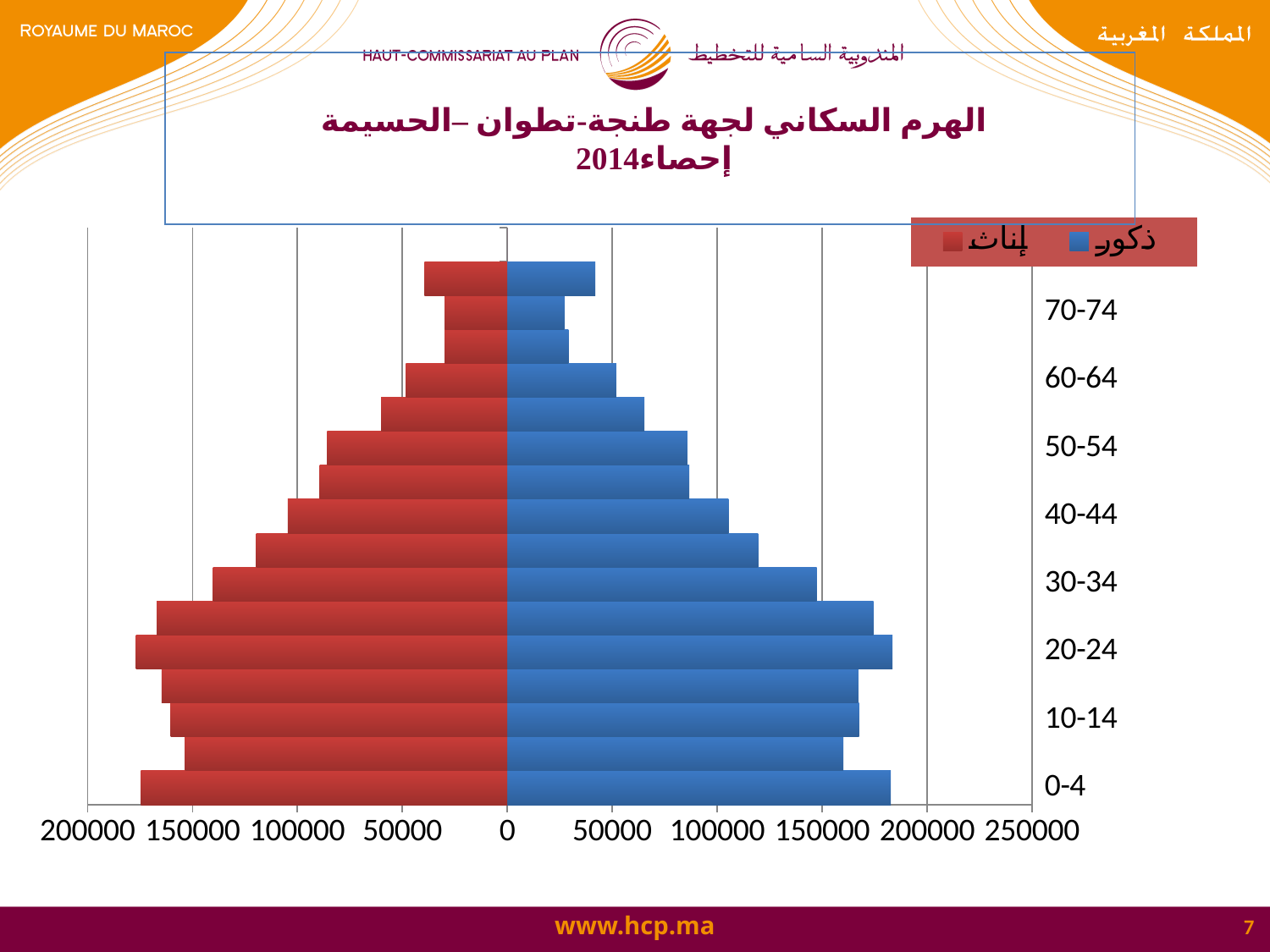
Is the value for males (ذكور) in the 50-54 age group greater or less than 100000? less Is the value for females (إناث) in the 0-4 age group greater or less than 150000? greater Is the value for males (ذكور) in the 0-4 age group greater or less than 150000? greater What kind of chart is shown on the slide? bar chart Which colour represents the ذكور (males) series? blue As the age groups increase from 0-4 to 70-74, do the bars generally get longer or shorter? shorter Which is larger: the male (ذكور) value for the 0-4 age group or for the 70-74 age group? 0-4 How many series does the legend list? 2 Which census year is given in the chart title? 2014